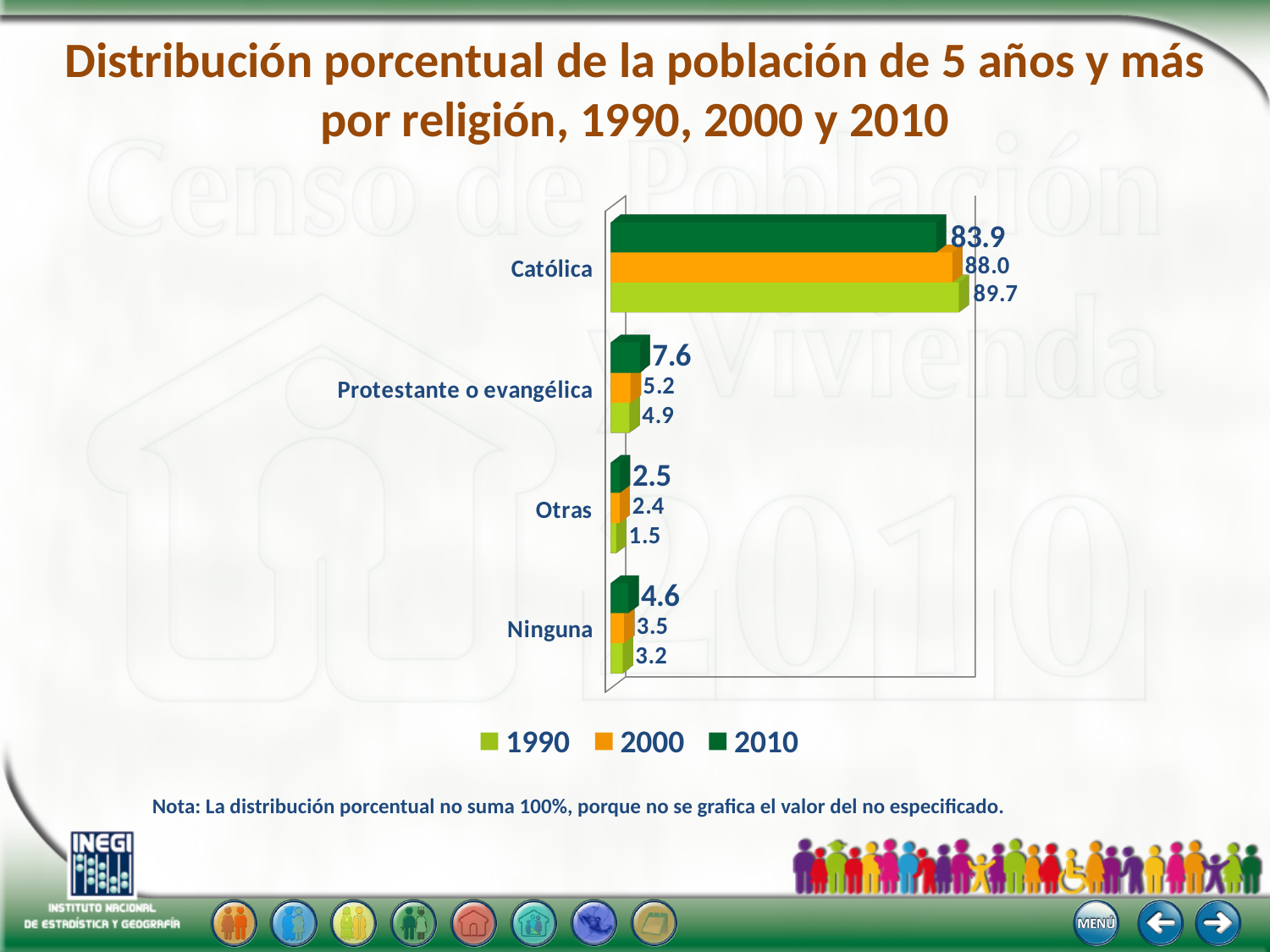
What is the value for Ninguna in 2000? 3.5 Which is larger: the 2010 value for Ninguna or the 2010 value for Otras? Ninguna Which category has the lowest value in 2000? Otras Which colour represents the year 2000 in the legend? Orange How many religion categories are shown on the chart? 4 What is the value for Protestante o evangélica in 1990? 4.9 Which category has the highest value in 1990? Católica What is the value for Católica in 2010? 83.9 What kind of chart is shown on the slide? Bar chart What is the value for Otras in 2010? 2.5 What is the difference between the Católica values for 1990 and 2010? 5.8 How many series does the legend list? 3